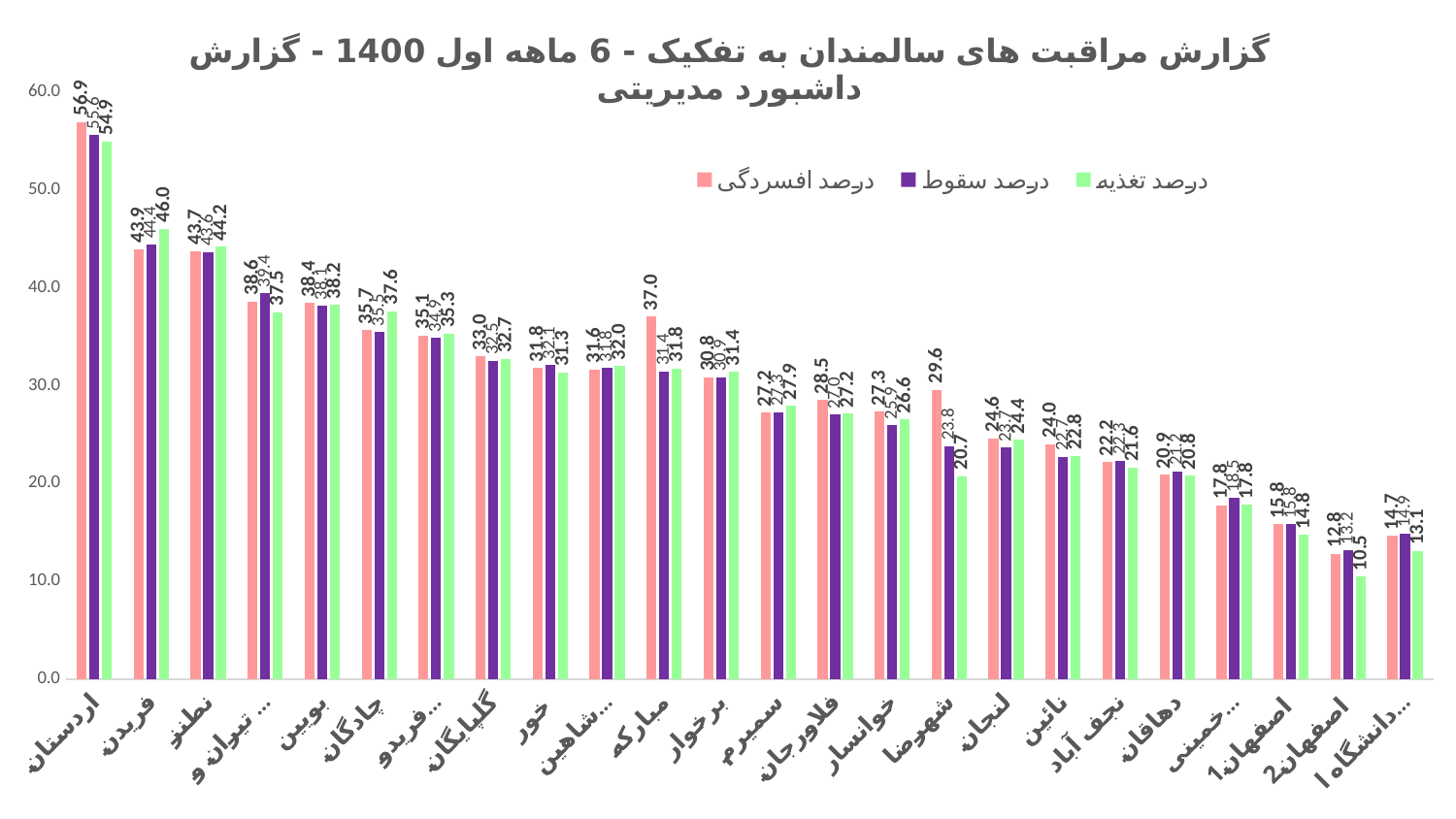
Which category has the lowest value of درصد تغذیه? اصفهان2 What is the value of درصد تغذیه for شهرضا? 20.7 What type of chart is shown on the slide? bar chart What is the difference between درصد افسردگی and درصد تغذیه for شهرضا? 8.9 What is the value of درصد تغذیه for فریدن? 46.0 Which category has the highest value of درصد افسردگی? اردستان Which is larger for مبارکه: درصد افسردگی or درصد تغذیه? درصد افسردگی What is the value of درصد افسردگی for اردستان? 56.9 How many categories are shown along the x axis? 24 How many series does the legend list? 3 What is the value of درصد افسردگی for مبارکه? 37.0 Do the درصد افسردگی values generally rise or fall from left to right along the x axis? fall